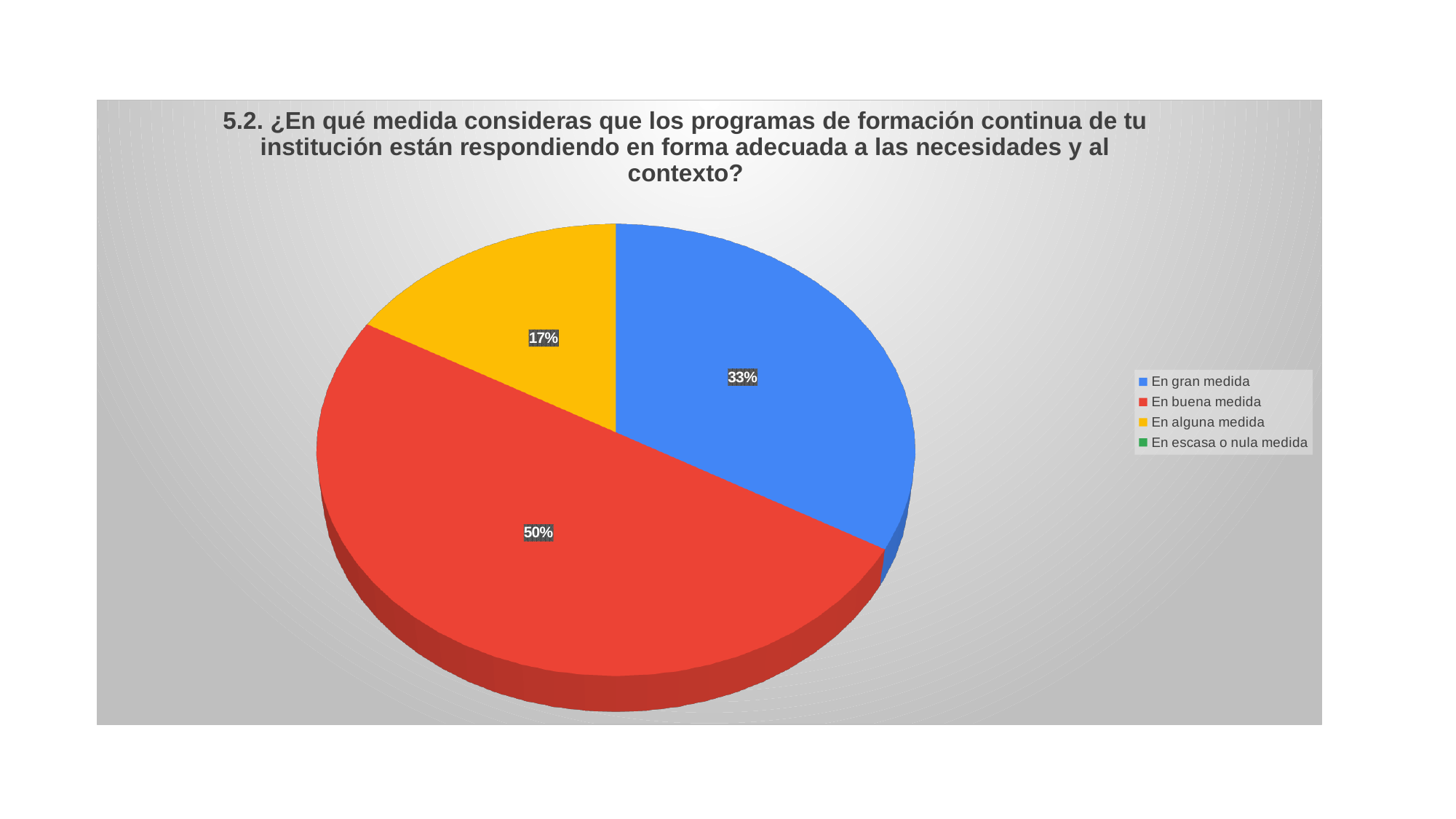
Which category has the largest share of the pie? En buena medida What share of the pie does "En gran medida" represent? 33% Which category with a visible slice has the smallest share of the pie? En alguna medida Which legend entry has no visible slice in the pie? En escasa o nula medida What share of the pie does "En buena medida" represent? 50% What is the difference in percentage points between "En buena medida" and "En gran medida"? 17 What kind of chart is shown on the slide? Pie chart What share of the pie does "En alguna medida" represent? 17% How many entries does the legend list? 4 What colour is the slice for "En alguna medida"? Yellow Which is larger, the share for "En gran medida" or the share for "En alguna medida"? En gran medida What is the difference in percentage points between "En gran medida" and "En alguna medida"? 16